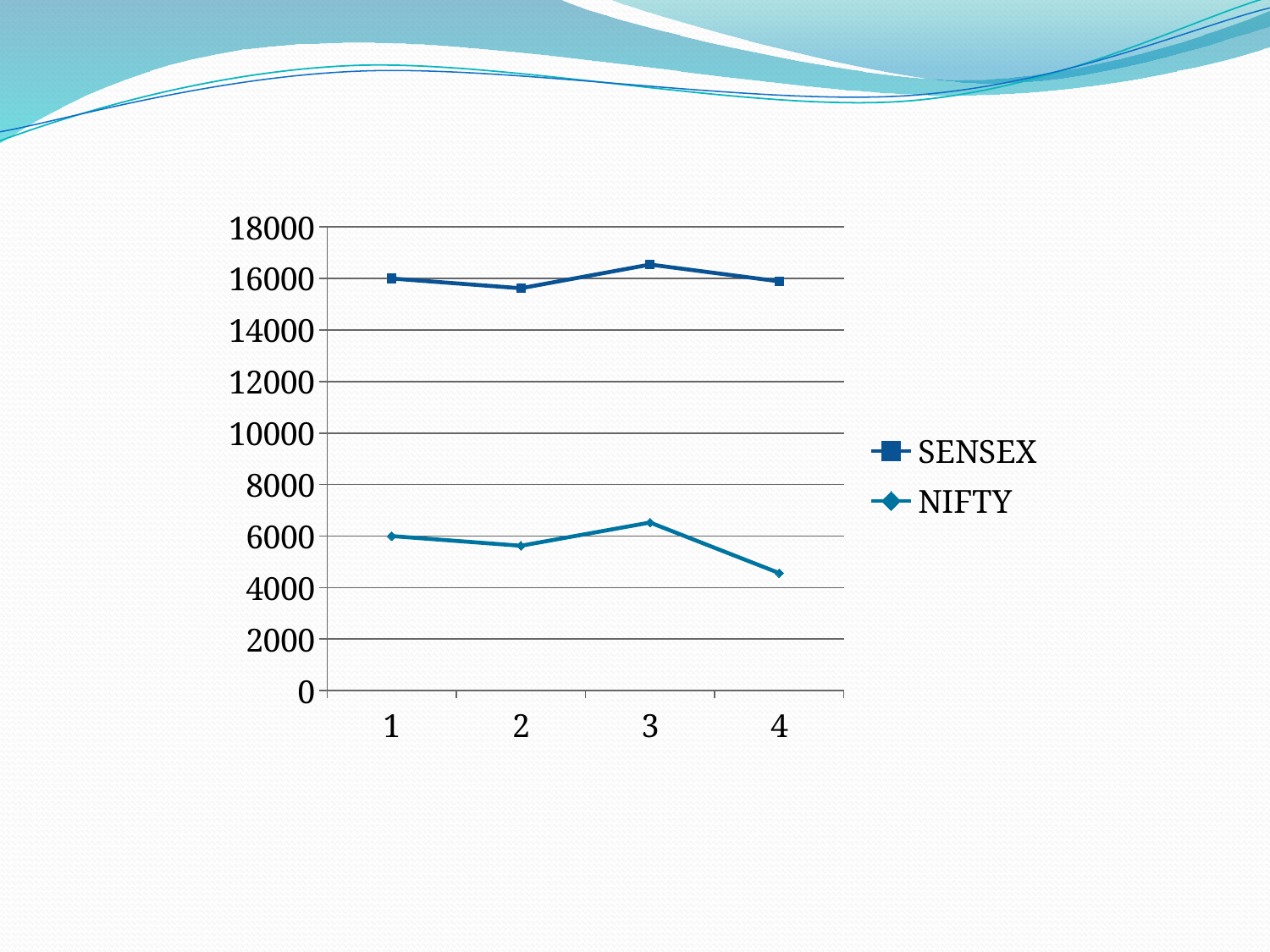
Does the NIFTY series rise or fall from point 3 to point 4? fall Which series does the legend list first? SENSEX How many series does the legend list? 2 How many points are plotted along the x axis for each series? 4 Is the value for SENSEX at point 2 greater or less than 16000? less Is the value for NIFTY at point 4 greater or less than 6000? less At which x-axis point does the NIFTY series reach its lowest value? 4 What kind of chart is shown on the slide? line chart Is the value for SENSEX at point 3 greater or less than 16000? greater At which x-axis point does the NIFTY series reach its highest value? 3 Which series has the larger value at point 4, SENSEX or NIFTY? SENSEX At which x-axis point does the SENSEX series reach its highest value? 3